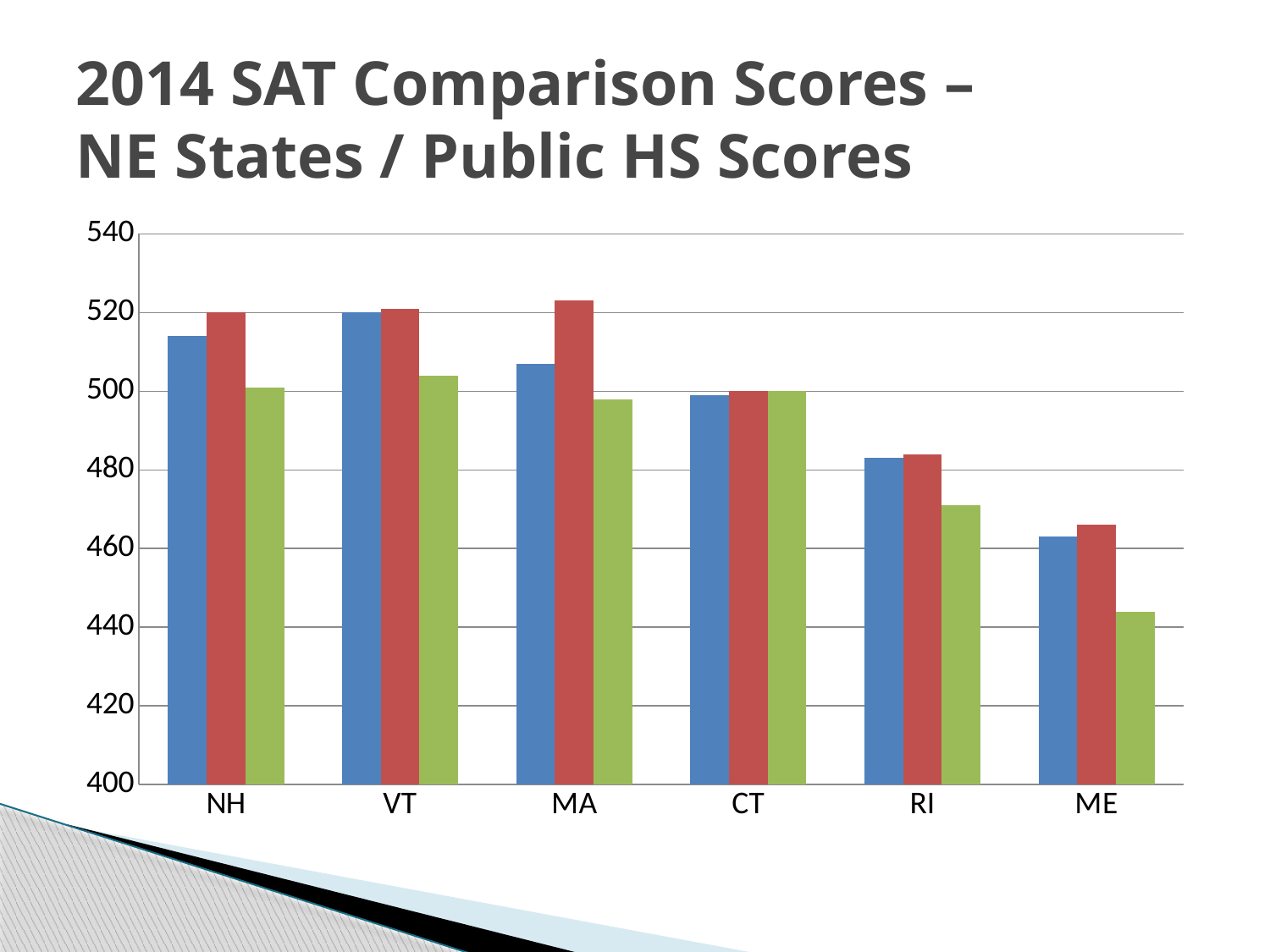
How many bars are plotted for each state in the chart? 3 Which state has the shortest green bar in the chart? ME How many states are shown on the x axis of the chart? 6 Is the blue bar for MA greater or less than 500? greater Is the red bar for MA greater or less than 520? greater Which is larger, the blue bar for NH or the blue bar for VT? VT Which state has the shortest blue bar in the chart? ME Is the green bar for ME greater or less than 460? less Which state has the tallest red bar in the chart? MA What kind of chart is shown on the slide? bar chart Do the blue bars generally rise or fall moving from NH to ME along the x axis? fall